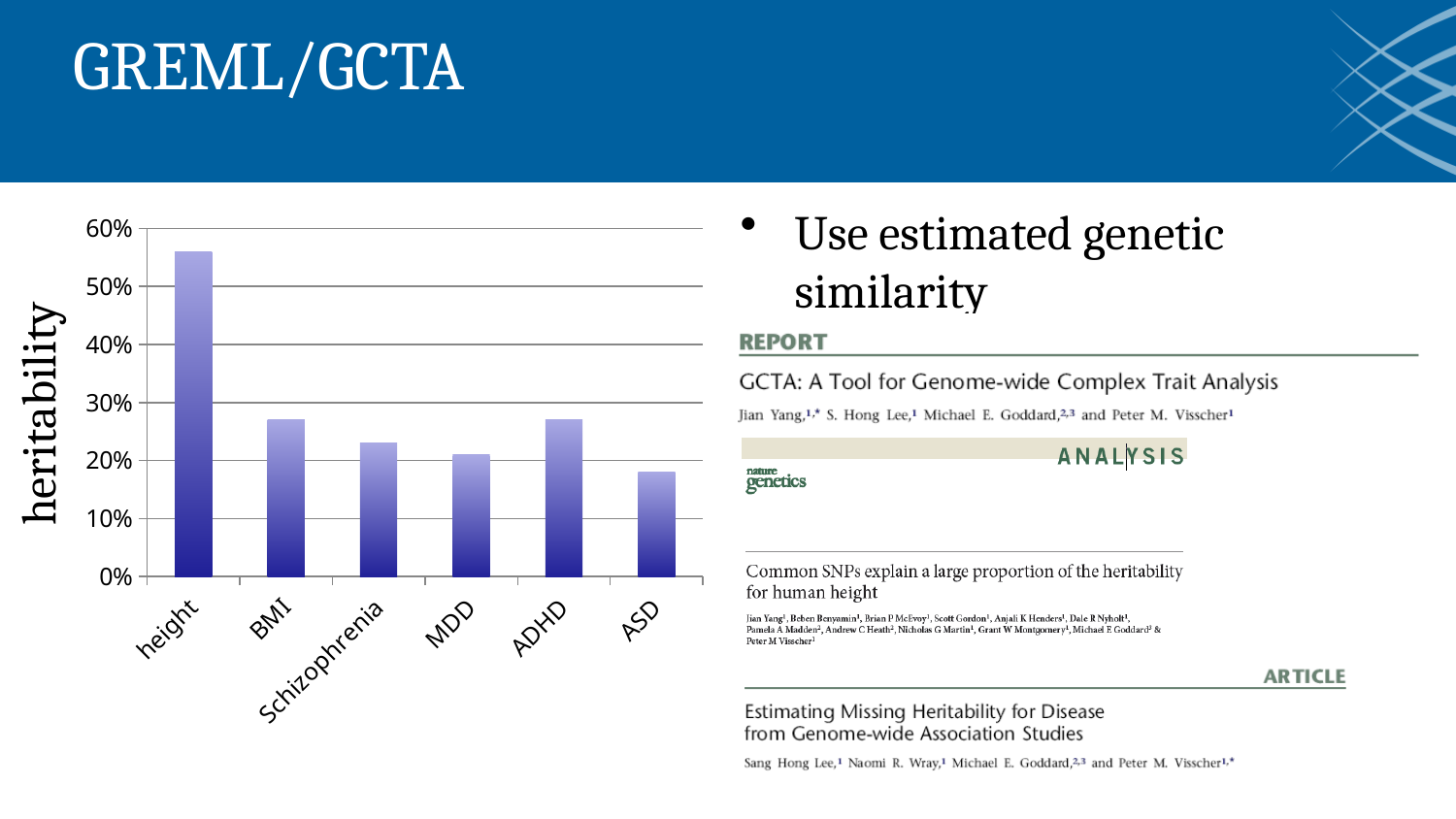
What is the label on the y axis of the chart? heritability Is the heritability value for Schizophrenia greater or less than 30%? less Is the heritability value for ASD greater or less than 20%? less Which has the larger heritability, ADHD or ASD? ADHD How many categories are shown on the x axis of the chart? 6 Which category has the highest heritability in the chart? height Is the heritability value for BMI greater or less than 20%? greater Which has the larger heritability, height or BMI? height What kind of chart is shown on the slide? bar chart Which category has the lowest heritability in the chart? ASD